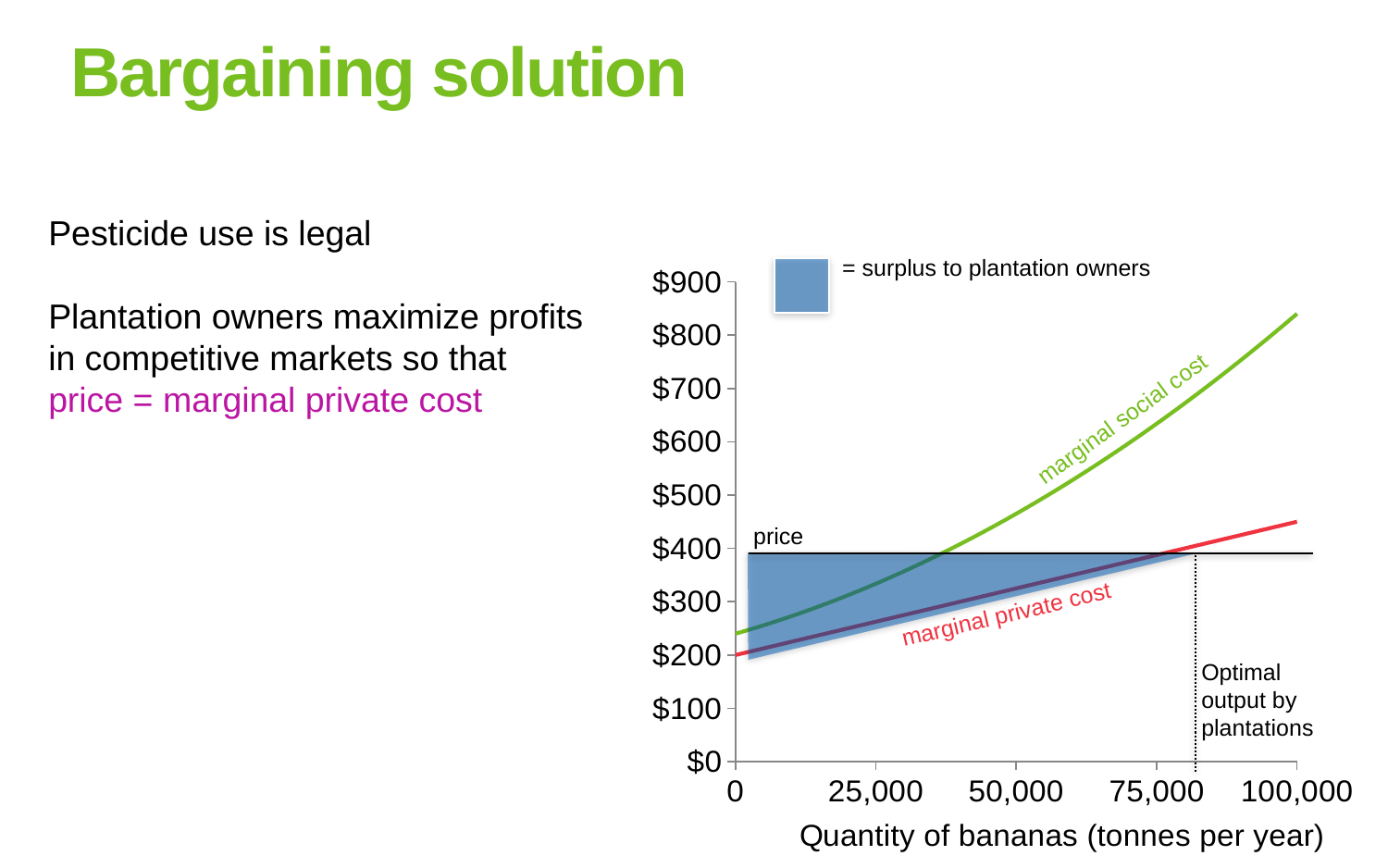
Is the price line greater or less than $500? less Does the marginal social cost curve rise or fall as quantity increases? rise Is the marginal social cost at a quantity of 0 greater or less than $200? greater What is the label of the x axis? Quantity of bananas (tonnes per year) Is the marginal private cost at a quantity of 100,000 greater or less than $400? greater What kind of chart is shown on the slide? line chart How many cost curves are labelled on the chart? 2 Does the marginal private cost curve rise or fall as quantity increases? rise According to the legend, what does the blue shaded area represent? surplus to plantation owners At a quantity of 100,000, which is higher: marginal social cost or marginal private cost? marginal social cost